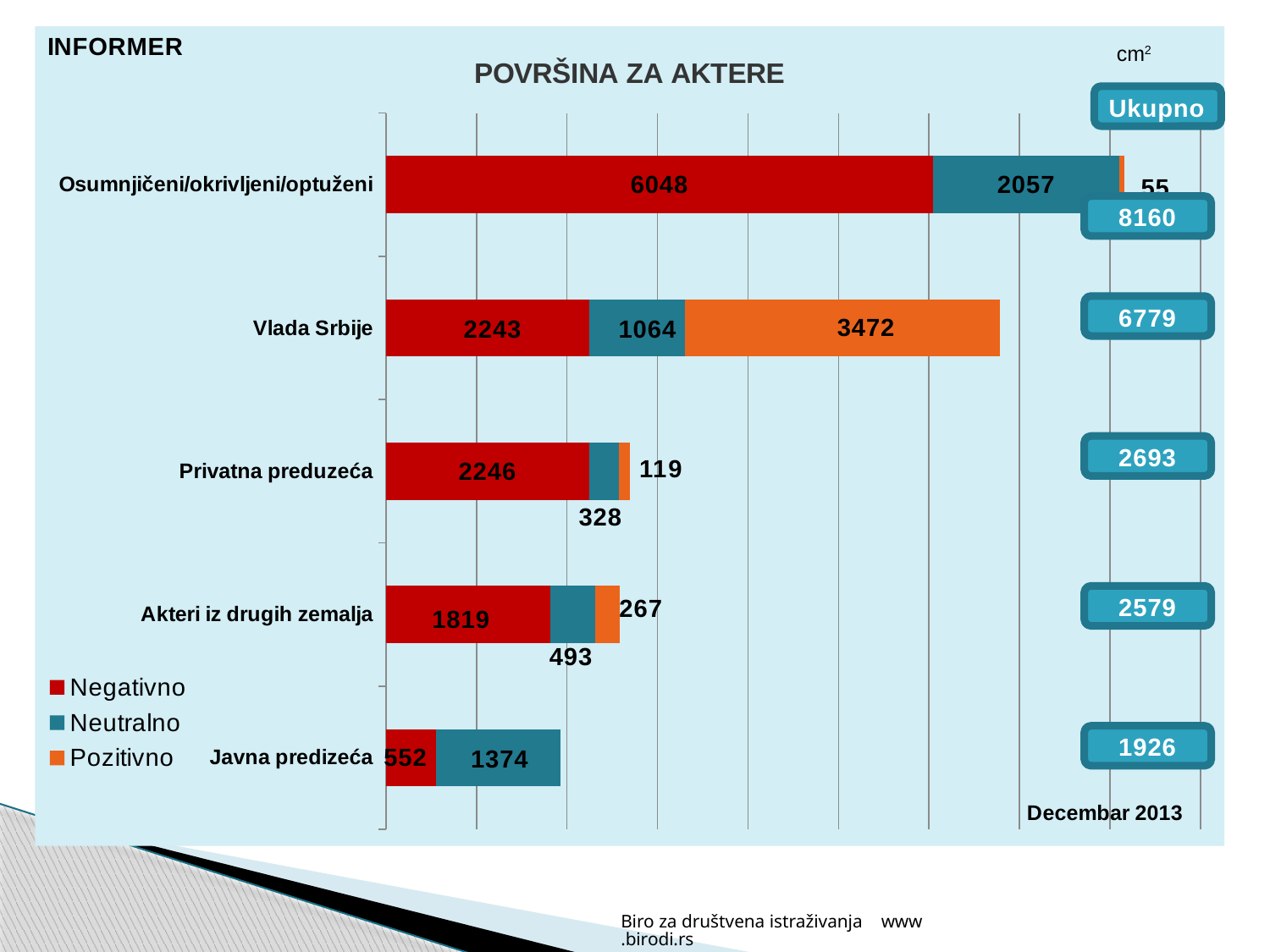
Which has the larger Neutralno value, Vlada Srbije or Javna predizeća? Javna predizeća What is the Neutralno value for Javna predizeća? 1374 What is the Pozitivno value for Akteri iz drugih zemalja? 267 What is the difference between the Negativno value for Osumnjičeni/okrivljeni/optuženi and the Negativno value for Vlada Srbije? 3805 How many categories are shown on the chart? 5 What is the Pozitivno value for Vlada Srbije? 3472 What kind of chart is shown on the slide? Stacked bar chart What is the total (Ukupno) for Osumnjičeni/okrivljeni/optuženi? 8160 Which category has the highest total (Ukupno)? Osumnjičeni/okrivljeni/optuženi How many series does the legend list? 3 Which category has the lowest total (Ukupno)? Javna predizeća What is the Negativno value for Vlada Srbije? 2243